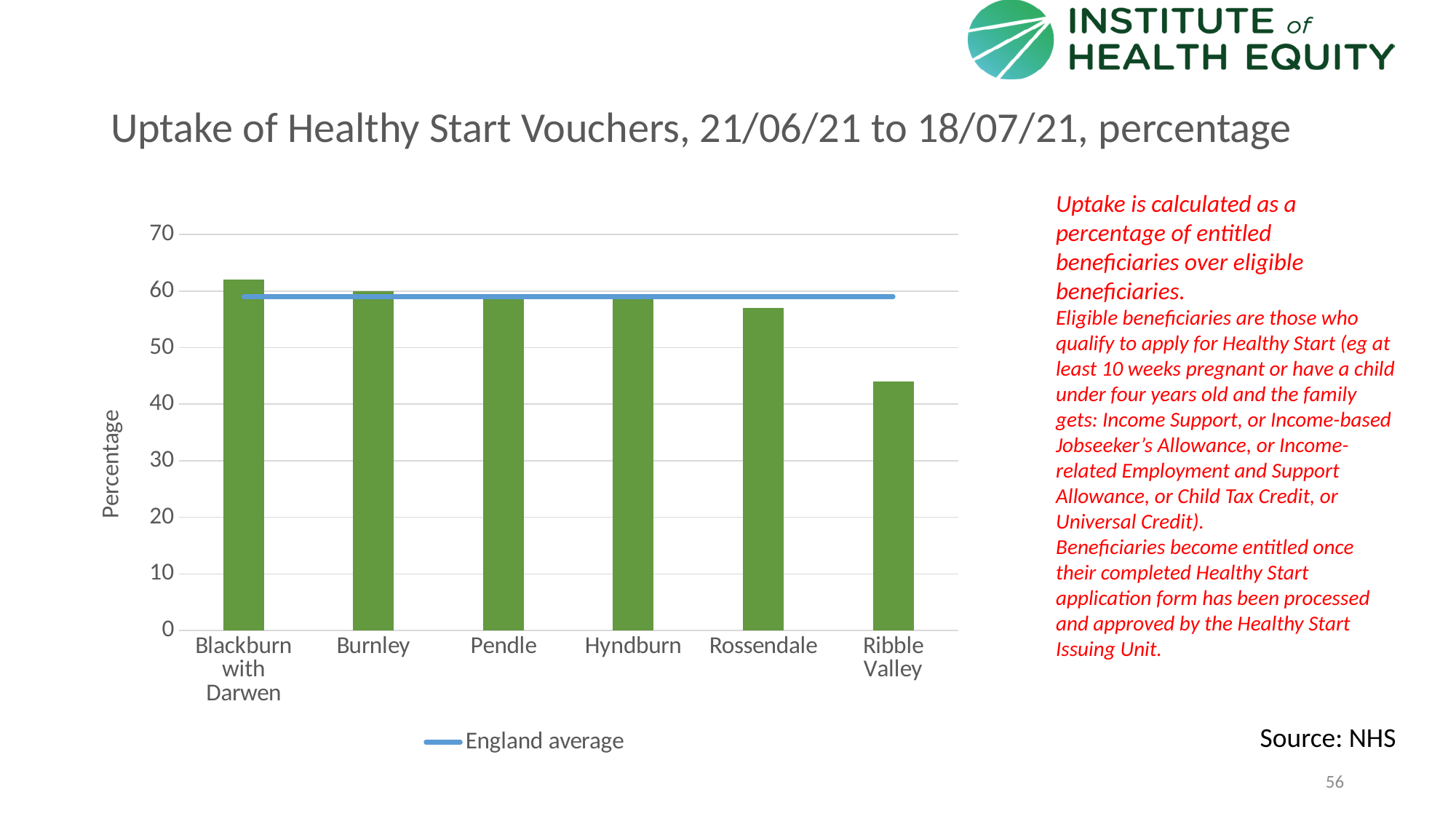
Is the value for Ribble Valley greater or less than 50? less Which area has the lowest uptake of Healthy Start vouchers? Ribble Valley Is the value for Hyndburn greater or less than 40? greater What is the label on the vertical axis of the chart? Percentage Which is larger, the value for Rossendale or the value for Ribble Valley? Rossendale Is the value for Rossendale greater or less than 50? greater What kind of chart is shown on the slide? bar chart Which area has the highest uptake of Healthy Start vouchers? Blackburn with Darwen Do the bar values generally rise or fall from left to right across the x axis? fall What does the blue horizontal line in the chart represent, according to the legend? England average How many local areas are plotted on the x axis of the chart? 6